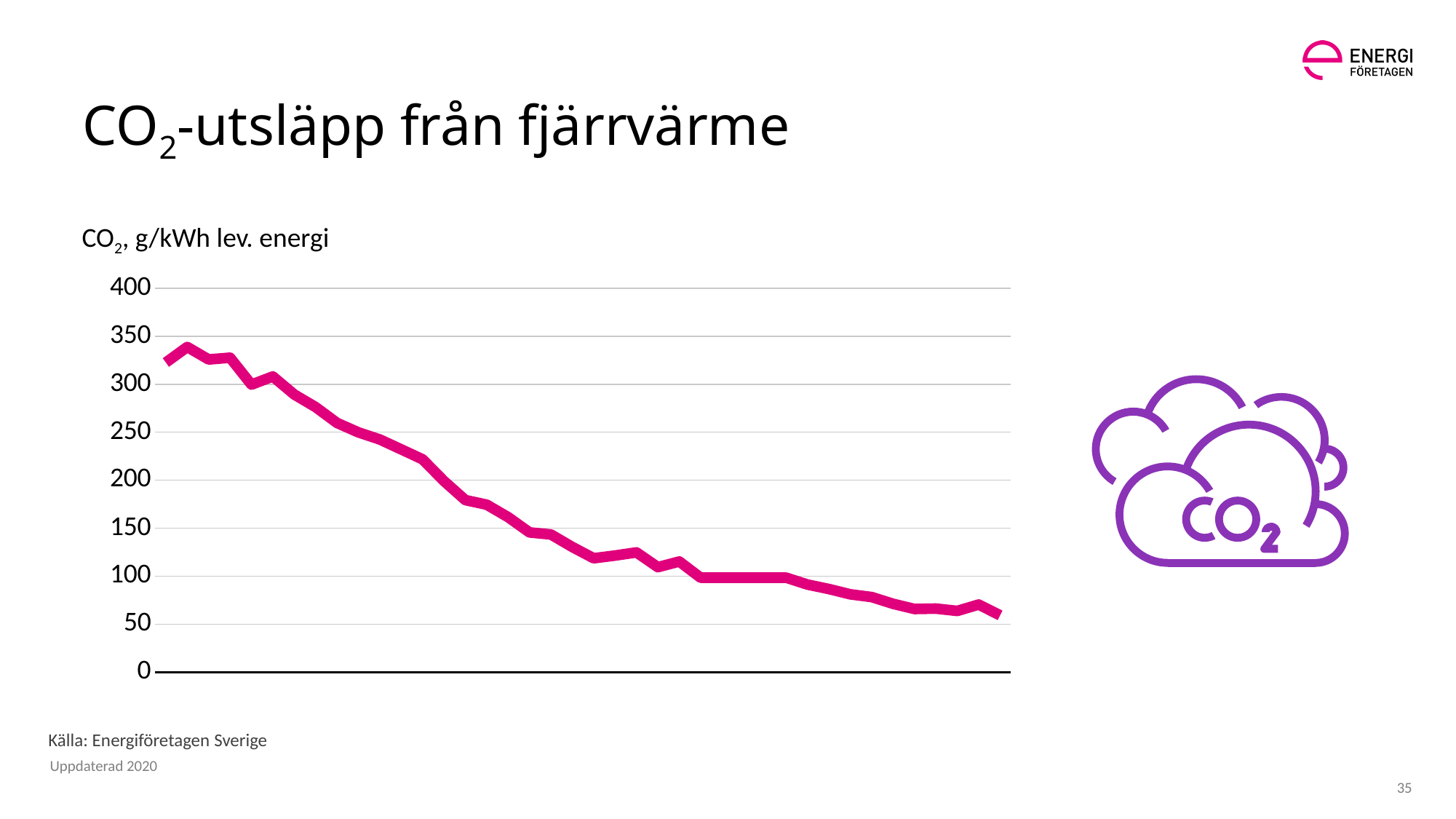
Is the value at the start of the line greater or less than 300? greater Is the value at the end of the line greater or less than 50? greater Is the value at the end of the line greater or less than 100? less What kind of chart is shown on the slide? line chart Do the CO2 emission values rise or fall along the x axis overall? fall How many lines are plotted on the chart? 1 What unit is given for the y axis of the chart? CO2, g/kWh lev. energi What is the title of the chart on the slide? CO2-utsläpp från fjärrvärme Which is larger, the value at the start of the line or the value at the end of the line? the value at the start